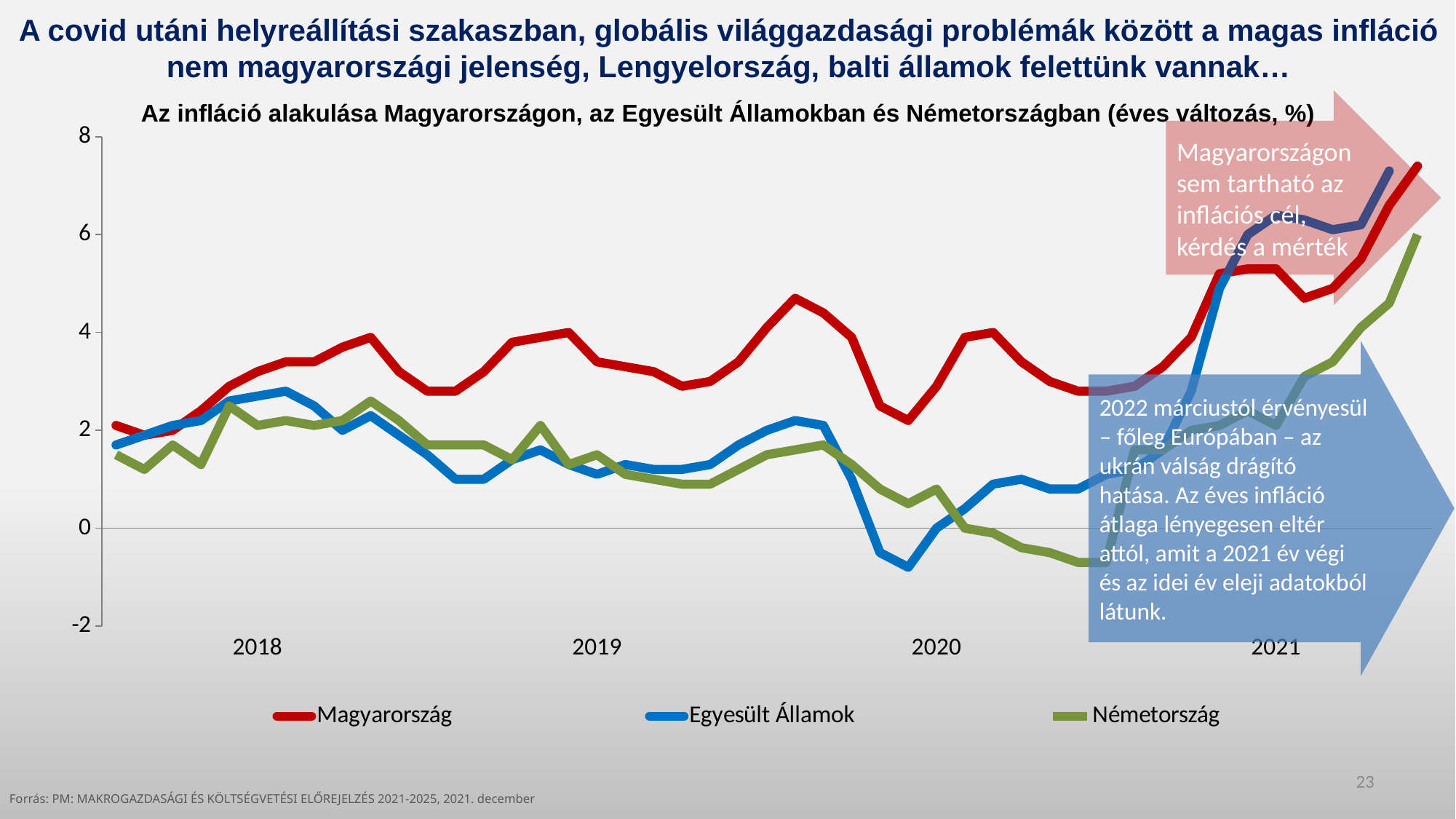
Which series are listed in the legend? Magyarország, Egyesült Államok, Németország Is the value for Magyarország at the start of the chart (2018) greater or less than 4? less What colour is the Magyarország line? red Is the lowest value for Egyesült Államok around the end of 2020 greater or less than 0? less How many year labels are shown on the x axis? 4 How many series does the legend list? 3 Does the Magyarország line rise or fall over the course of 2021? rise At the end of 2021, which is higher: Magyarország or Németország? Magyarország Is the value for Németország at the end of 2021 greater or less than 4? greater What kind of chart is shown on the slide? line chart Which series has the lowest value at the end of 2021? Németország